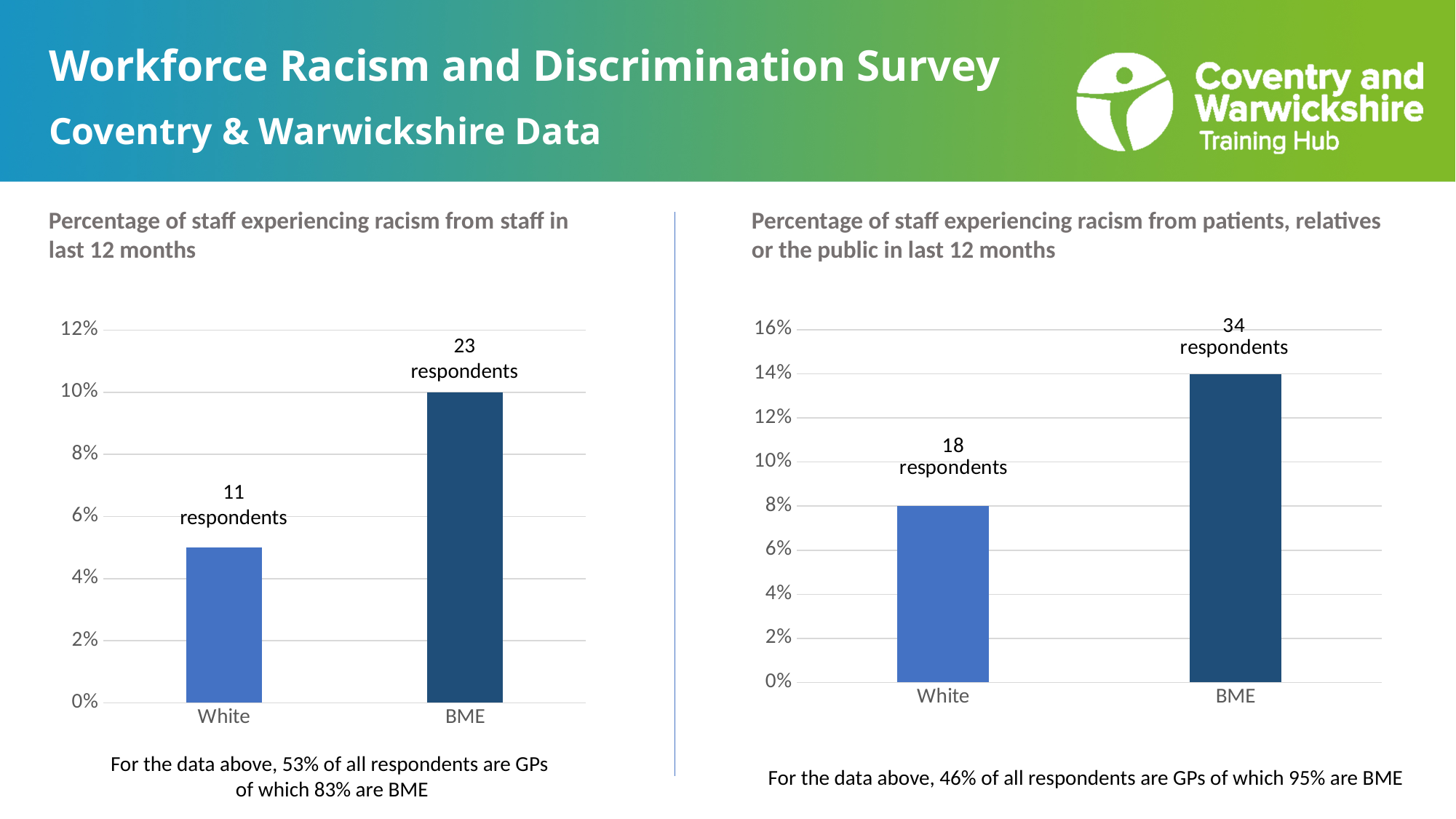
In the chart 'Percentage of staff experiencing racism from staff in last 12 months', how many respondents does the label on the BME bar show? 23 respondents In the chart 'Percentage of staff experiencing racism from staff in last 12 months', how many respondents does the label on the White bar show? 11 respondents What kind of chart is the chart on the left of the slide? bar chart How many categories are shown on the x axis of the chart on the right of the slide? 2 In the chart 'Percentage of staff experiencing racism from staff in last 12 months', what percentage is shown for BME? 10% In the chart 'Percentage of staff experiencing racism from patients, relatives or the public in last 12 months', what percentage is shown for BME? 14% In the chart 'Percentage of staff experiencing racism from staff in last 12 months', which category has the higher value? BME In the chart 'Percentage of staff experiencing racism from patients, relatives or the public in last 12 months', which category has the lowest value? White In the chart 'Percentage of staff experiencing racism from patients, relatives or the public in last 12 months', what is the difference between the BME and White percentages? 6% In the chart 'Percentage of staff experiencing racism from patients, relatives or the public in last 12 months', what percentage is shown for White? 8% In the chart 'Percentage of staff experiencing racism from patients, relatives or the public in last 12 months', how many respondents does the label on the BME bar show? 34 respondents In the chart 'Percentage of staff experiencing racism from staff in last 12 months', is the value for White greater or less than 6%? less